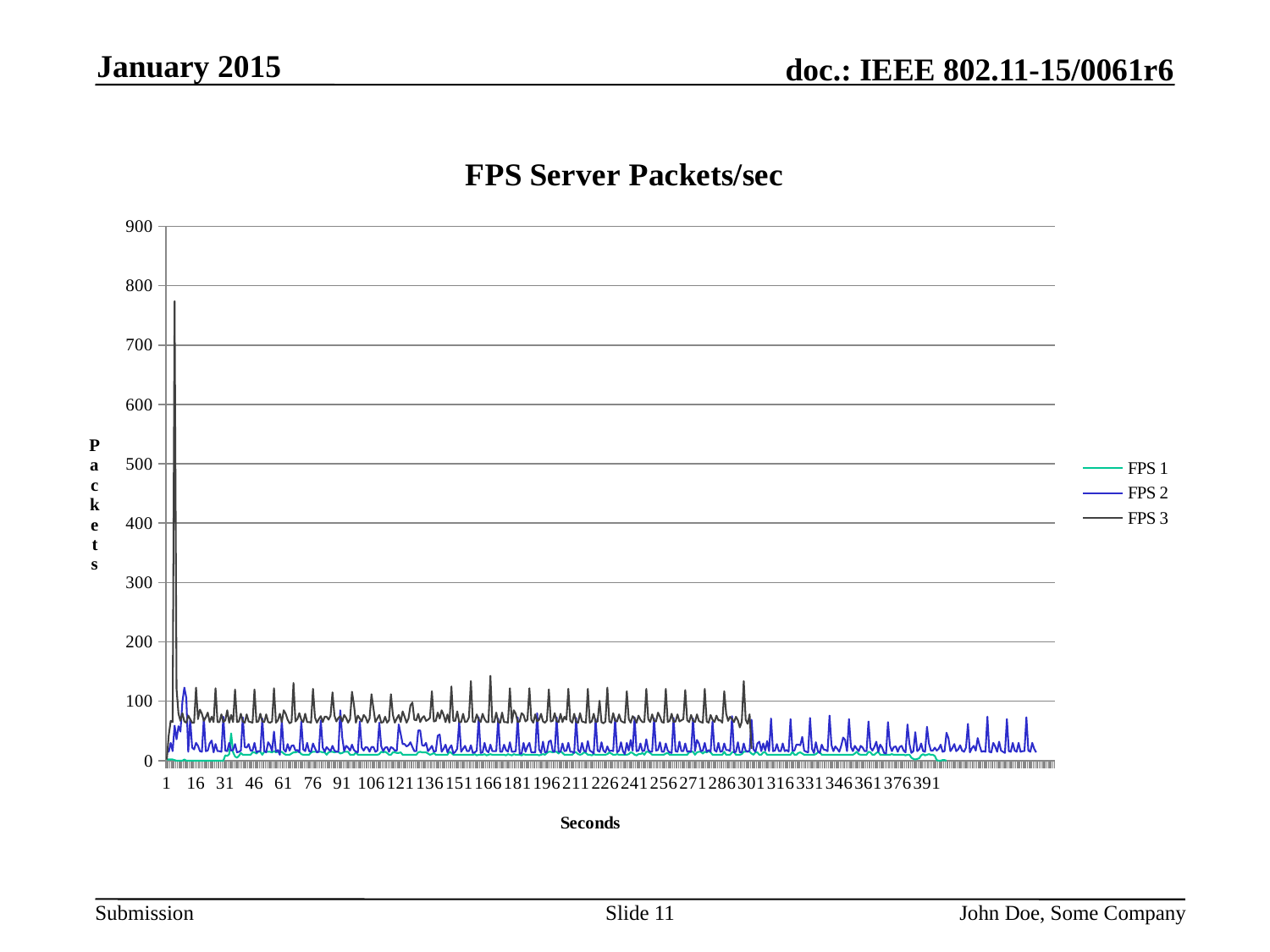
What is the title of the chart? FPS Server Packets/sec Which series reaches the highest peak value on the chart? FPS 3 How many series does the legend list? 3 Is the highest peak of FPS 3 greater or less than 700? greater Which series stays lowest across the chart? FPS 1 What is the highest tick value shown on the vertical axis? 900 Is the highest value of FPS 2 greater or less than 200? less What kind of chart is shown on the slide? line chart Are the values of FPS 1 greater or less than 100 throughout the chart? less What are the series names listed in the legend? FPS 1, FPS 2, FPS 3 Which series has larger values overall, FPS 2 or FPS 1? FPS 2